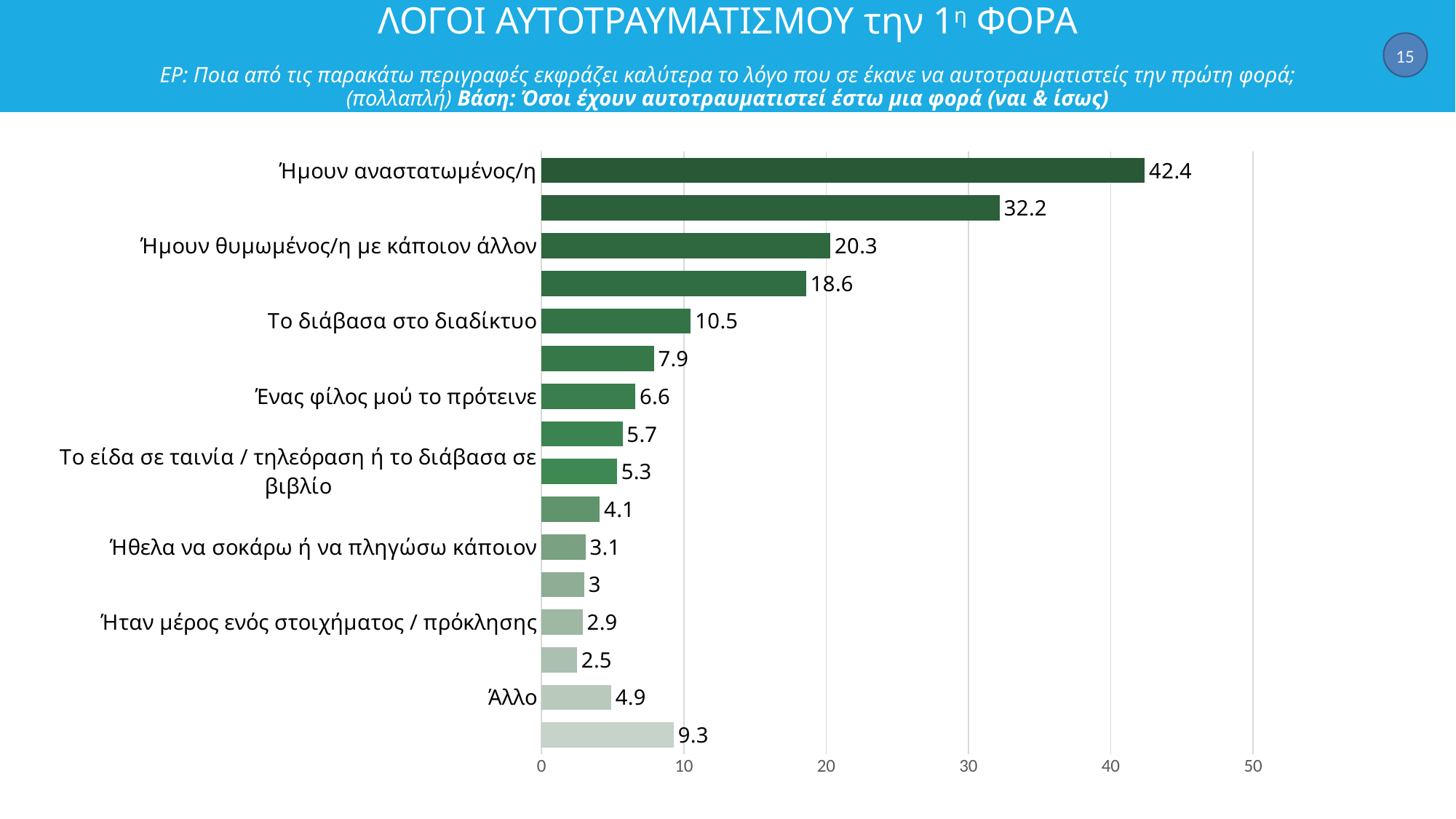
What kind of chart is shown on the slide? bar chart Is the value for 'Ήμουν θυμωμένος/η με κάποιον άλλον' greater or less than 30? less How many bars are plotted on the chart? 16 What is the difference between the values for 'Ήμουν αναστατωμένος/η' and 'Ήμουν θυμωμένος/η με κάποιον άλλον'? 22.1 What is the value for 'Άλλο'? 4.9 Which is larger, the value for 'Άλλο' or the value for 'Ήθελα να σοκάρω ή να πληγώσω κάποιον'? Άλλο What is the value for 'Το διάβασα στο διαδίκτυο'? 10.5 What is the value for 'Ένας φίλος μού το πρότεινε'? 6.6 What is the smallest value printed on the chart? 2.5 What is the value for 'Ήμουν αναστατωμένος/η'? 42.4 What is the value for 'Ήμουν θυμωμένος/η με κάποιον άλλον'? 20.3 Which labelled category has the highest value? Ήμουν αναστατωμένος/η